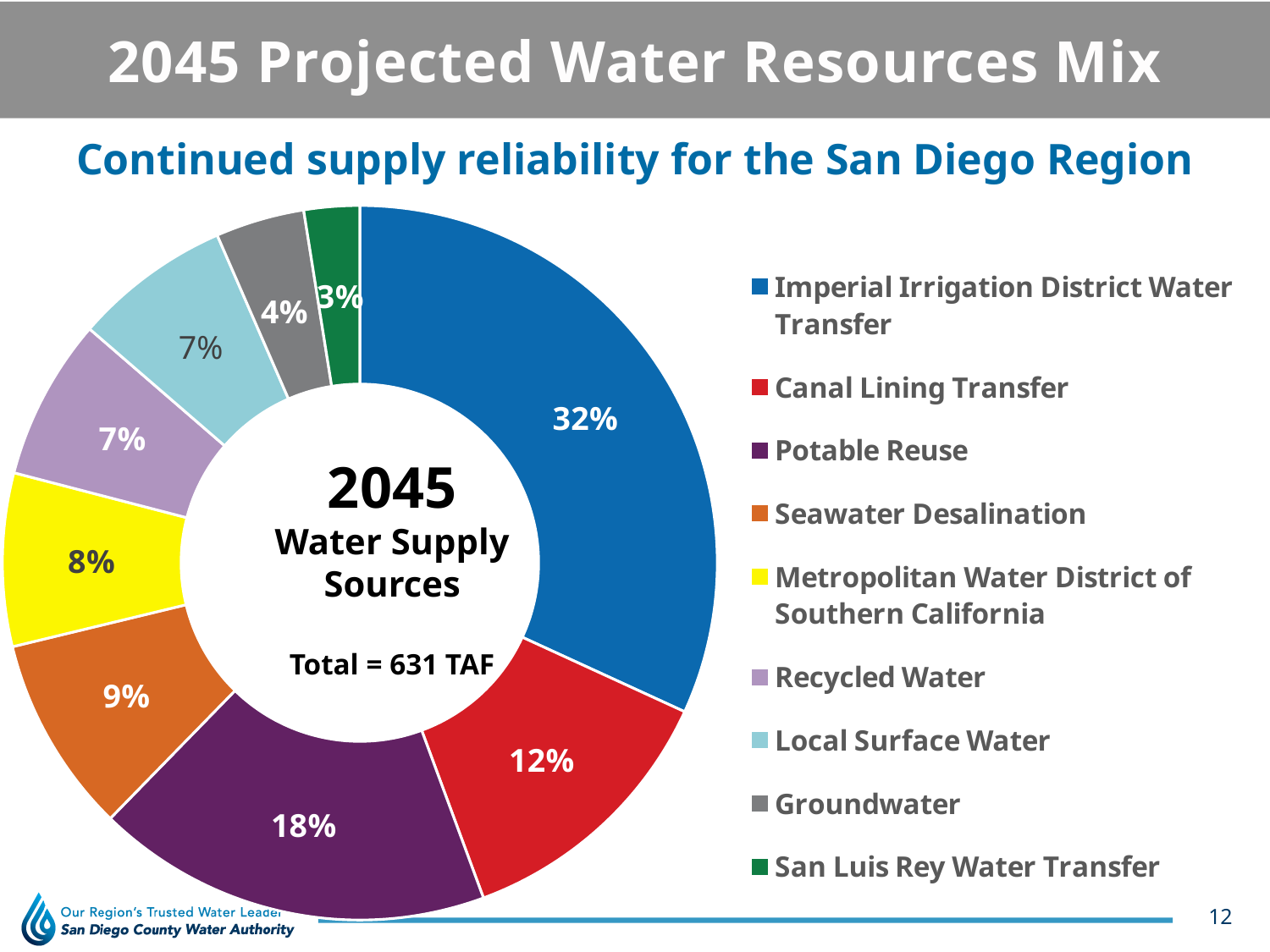
What share of the 2045 water supply sources is Potable Reuse? 18% How many water supply sources are shown in the chart? 9 What share of the 2045 water supply sources is Groundwater? 4% Which is larger, the share for Seawater Desalination or the share for Metropolitan Water District of Southern California? Seawater Desalination What total is printed in the center of the chart? Total = 631 TAF What is the difference in percentage points between Potable Reuse and Canal Lining Transfer? 6 What kind of chart is used to show the 2045 water supply sources? Pie chart (donut) What share of the 2045 water supply sources is Imperial Irrigation District Water Transfer? 32% Which water supply source has the largest share in the 2045 chart? Imperial Irrigation District Water Transfer Which water supply source has the smallest share in the 2045 chart? San Luis Rey Water Transfer What share of the 2045 water supply sources is Seawater Desalination? 9% What share of the 2045 water supply sources is Canal Lining Transfer? 12%